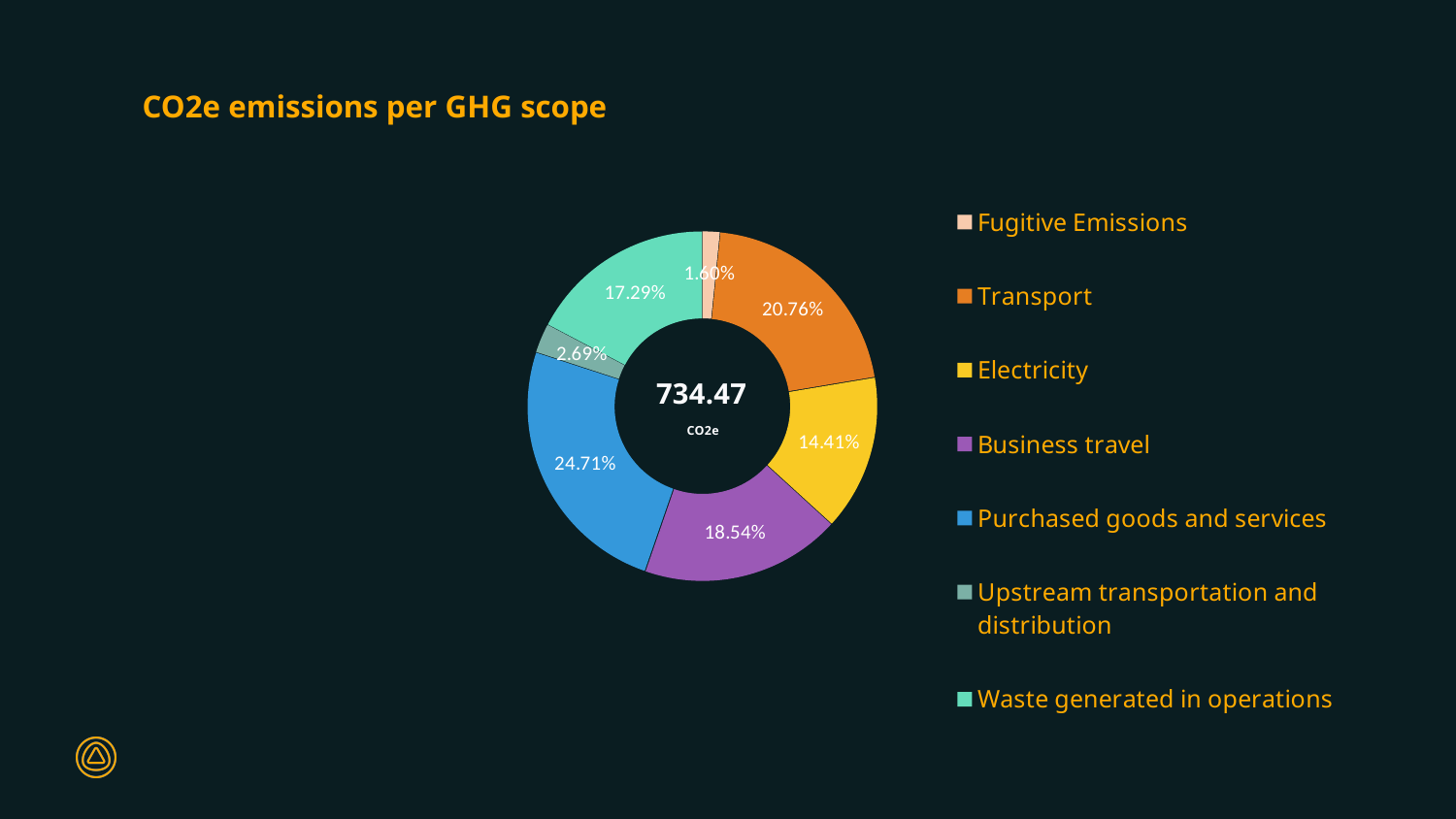
Which has a larger share of emissions, Transport or Business travel? Transport What share of CO2e emissions comes from Transport? 20.76% Which category has the smallest share of CO2e emissions? Fugitive Emissions How many categories does the legend list? 7 What type of chart is shown on the slide? Pie chart (donut) What share of CO2e emissions comes from Business travel? 18.54% What share of CO2e emissions comes from Purchased goods and services? 24.71% What total value is shown in the centre of the donut chart? 734.47 CO2e What share of CO2e emissions comes from Waste generated in operations? 17.29% Which category has the largest share of CO2e emissions? Purchased goods and services What share of CO2e emissions comes from Electricity? 14.41% What share of CO2e emissions comes from Upstream transportation and distribution? 2.69%